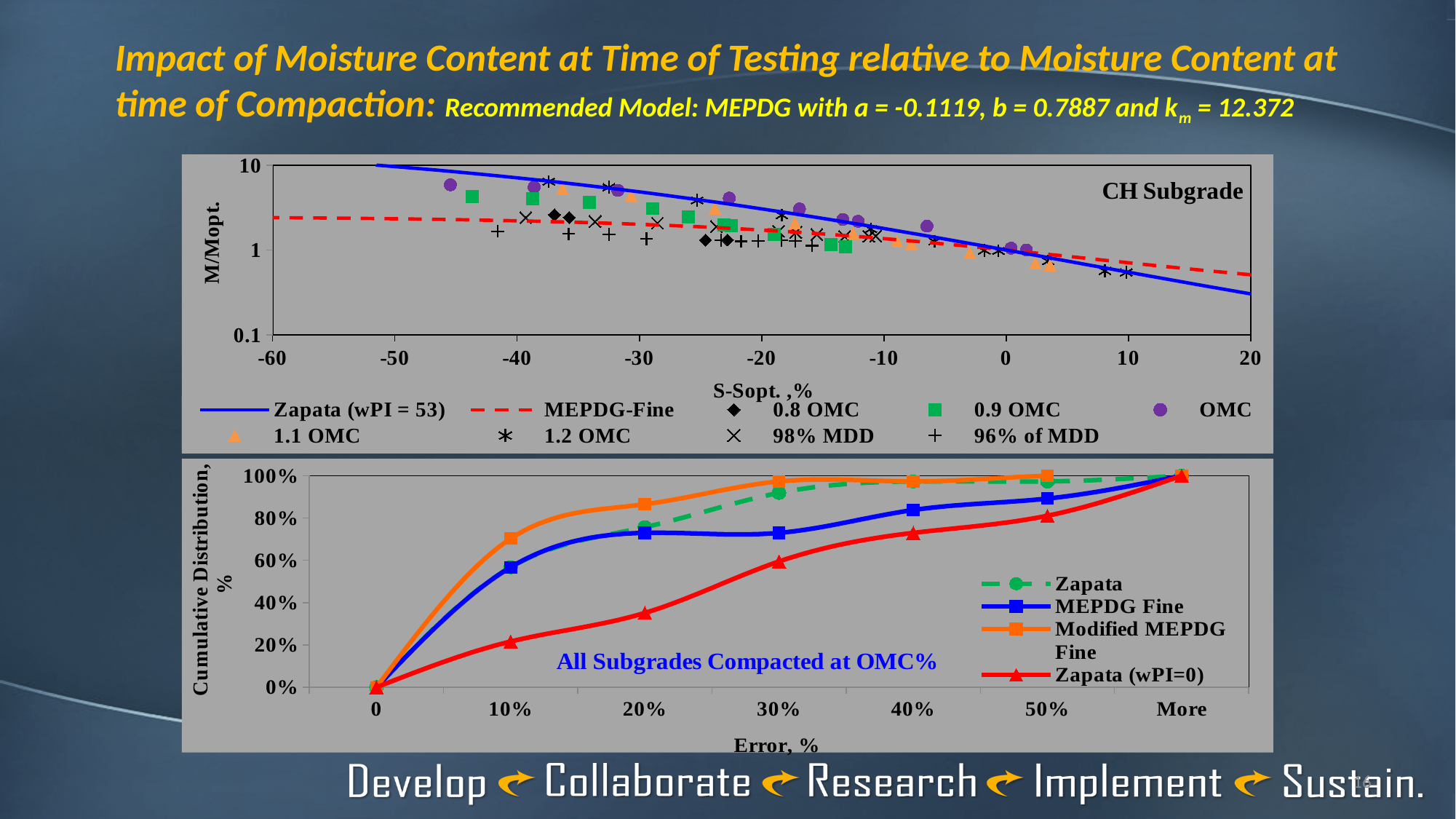
In the bottom chart, what is the cumulative distribution value of Zapata (wPI=0) at the 'More' category? 100% How many categories are on the x axis of the bottom chart? 7 How many series does the legend of the bottom chart list? 4 In the top chart, is the Zapata (wPI = 53) value at S-Sopt = 20 greater or less than 1? less What is the x-axis label of the bottom chart? Error, % In the bottom chart, is the Zapata (wPI=0) value at 10% error greater or less than 40%? less What is the title shown inside the top chart? CH Subgrade In the top chart, does the Zapata (wPI = 53) line rise or fall as S-Sopt increases? fall In the bottom chart, at 10% error, which is larger: Modified MEPDG Fine or Zapata (wPI=0)? Modified MEPDG Fine How many series does the legend of the top chart list? 9 What kind of chart is the bottom chart? line chart In the top chart, is the MEPDG-Fine value at S-Sopt = -60 greater or less than 1? greater